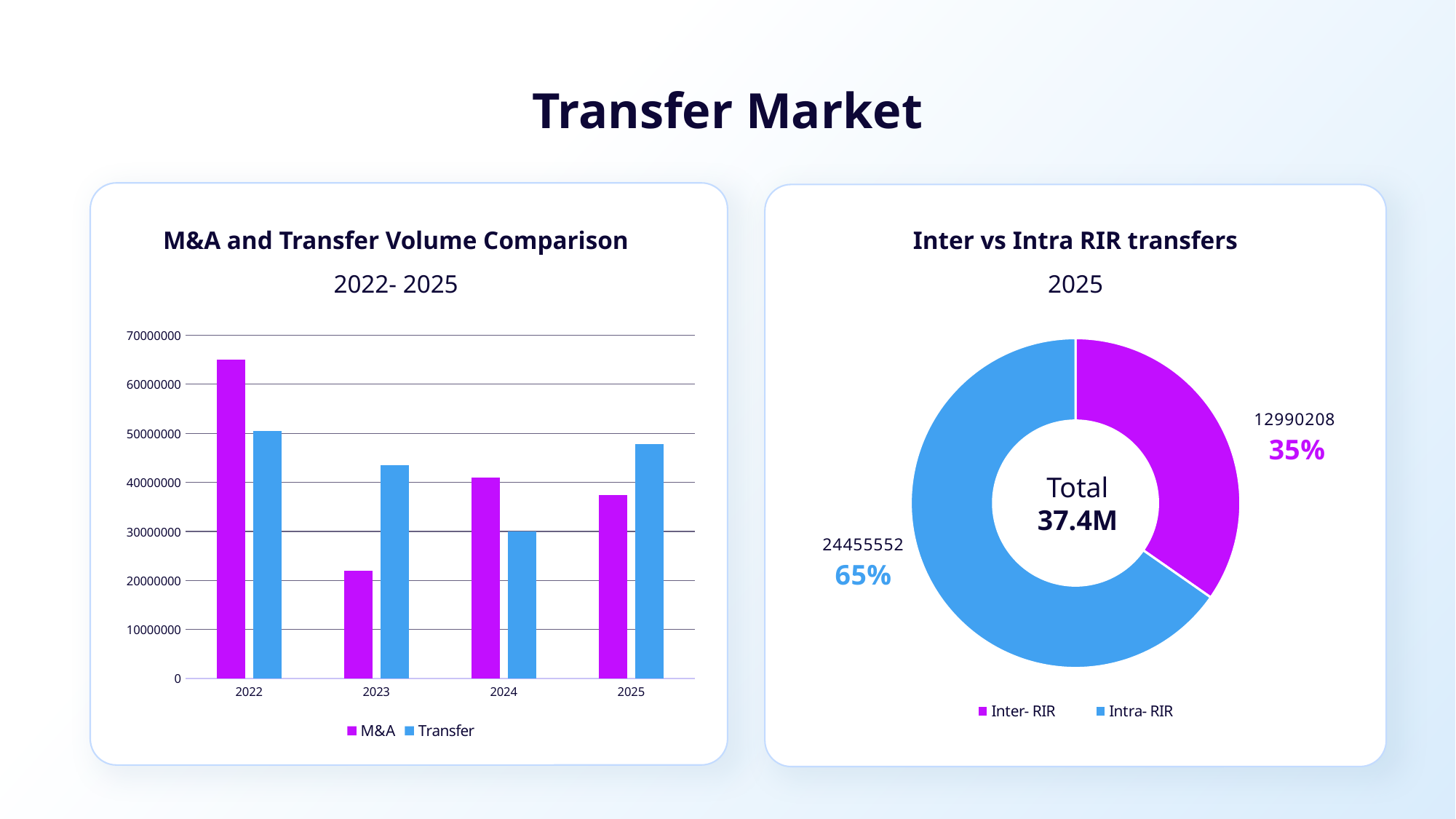
In the 'M&A and Transfer Volume Comparison' chart, which year has the highest M&A bar? 2022 In the 'M&A and Transfer Volume Comparison' chart, which year has the lowest Transfer bar? 2024 In the 'M&A and Transfer Volume Comparison' chart, is the M&A value for 2022 greater or less than 60000000? greater In the 'M&A and Transfer Volume Comparison' chart, which year has the lowest M&A bar? 2023 In the 'M&A and Transfer Volume Comparison' chart, is the M&A value for 2023 greater or less than 30000000? less In the 'Inter vs Intra RIR transfers' chart, what share of the total is Intra-RIR? 65% In the 'M&A and Transfer Volume Comparison' chart, how many series does the legend list? 2 In the 'M&A and Transfer Volume Comparison' chart, which is larger in 2023, M&A or Transfer? Transfer In the 'M&A and Transfer Volume Comparison' chart, how many years are shown on the x axis? 4 In the 'Inter vs Intra RIR transfers' chart, what is the value for Inter-RIR? 12990208 What kind of chart is the 'M&A and Transfer Volume Comparison' chart? bar chart In the 'M&A and Transfer Volume Comparison' chart, is the Transfer value for 2025 greater or less than 40000000? greater